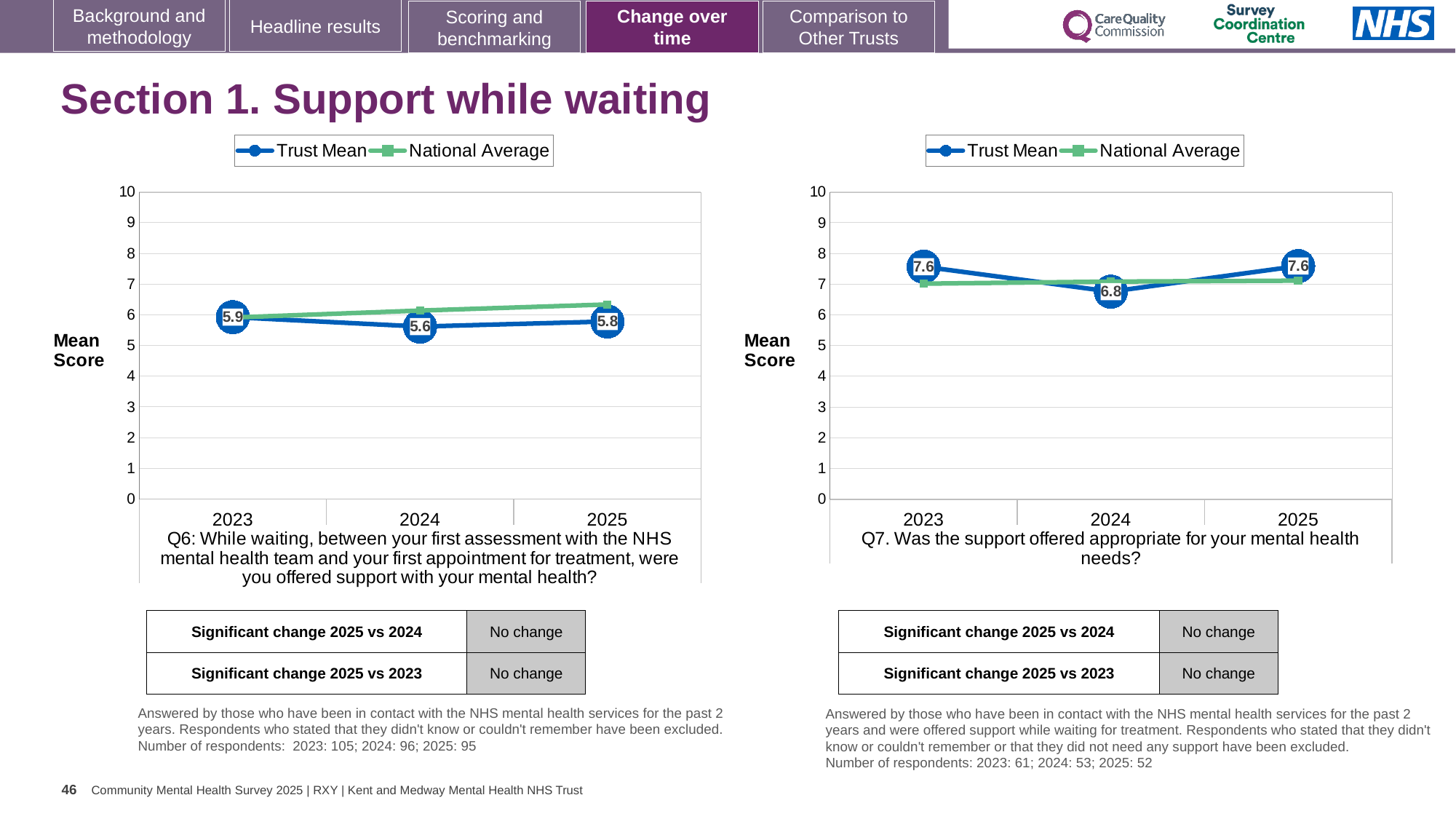
In the left chart (Q6), which year has the highest Trust Mean? 2023 How many years are plotted on the x axis of the left chart (Q6)? 3 In the left chart (Q6), what is the Trust Mean for 2024? 5.6 How many series does the legend of the left chart (Q6) list? 2 In the right chart (Q7), what is the difference between the Trust Mean for 2023 and 2024? 0.8 What kind of chart is the right chart (Q7)? Line chart In the left chart (Q6), what is the Trust Mean for 2023? 5.9 In the right chart (Q7), is the National Average for 2024 greater or less than 8? less In the right chart (Q7), what is the Trust Mean for 2025? 7.6 In the left chart (Q6), which year has the lowest Trust Mean? 2024 In the right chart (Q7), what is the Trust Mean for 2024? 6.8 In the left chart (Q6), is the Trust Mean for 2025 greater or less than the Trust Mean for 2024? greater